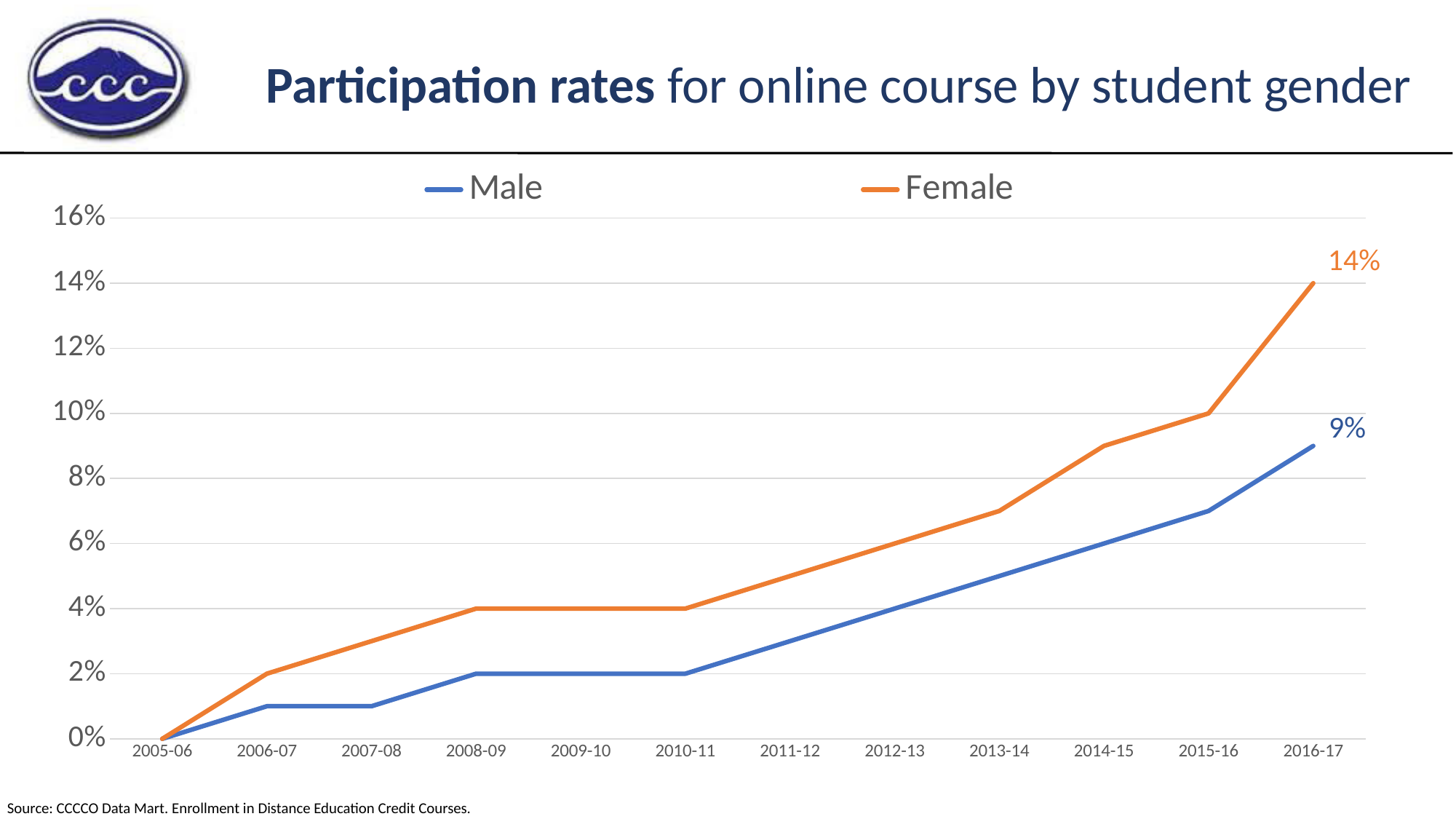
In which year is the Female participation rate highest? 2016-17 What is the Male participation rate in 2016-17? 9% What is the Female participation rate in 2016-17? 14% What type of chart is shown on the slide? line chart Is the Male participation rate in 2013-14 greater or less than 6%? less What is the difference between the Female and Male participation rates in 2016-17? 5% How many series does the legend list? 2 Which series has the higher participation rate in 2016-17, Male or Female? Female Does the Female participation rate rise or fall from 2005-06 to 2016-17? rise Is the Female participation rate in 2015-16 greater or less than 8%? greater How many academic years are shown on the x axis? 12 What colour is the line for the Female series? orange